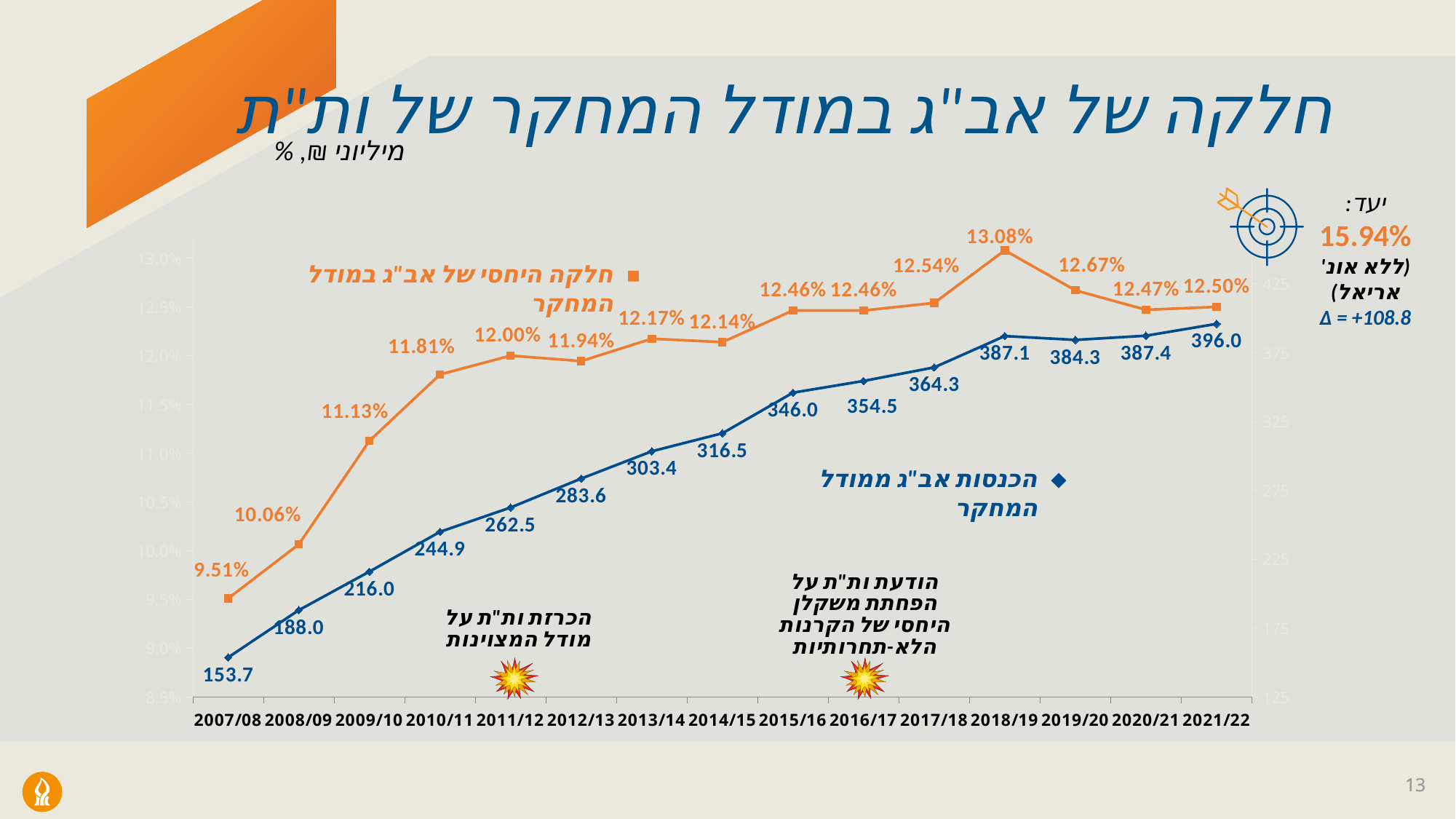
How many series does the chart's legend list? 2 What is the difference between the revenue values for 2021/22 and 2007/08? 242.3 Which is larger: the relative share in 2019/20 or in 2020/21? 2019/20 What is the value of the revenue series (הכנסות אב"ג ממודל המחקר) for 2021/22? 396.0 What is the value of the relative share series (חלקה היחסי של אב"ג במודל המחקר) for 2007/08? 9.51% How many academic years are plotted along the x axis? 15 What is the relative share value for 2011/12? 12.00% What target value (יעד) is shown at the top right of the chart? 15.94% Does the revenue series (blue line) generally rise or fall from 2007/08 to 2021/22? rise In which year does the relative share series (orange line) reach its highest value? 2018/19 What kind of chart is shown on the slide? line chart What is the lowest value of the revenue series (blue line)? 153.7